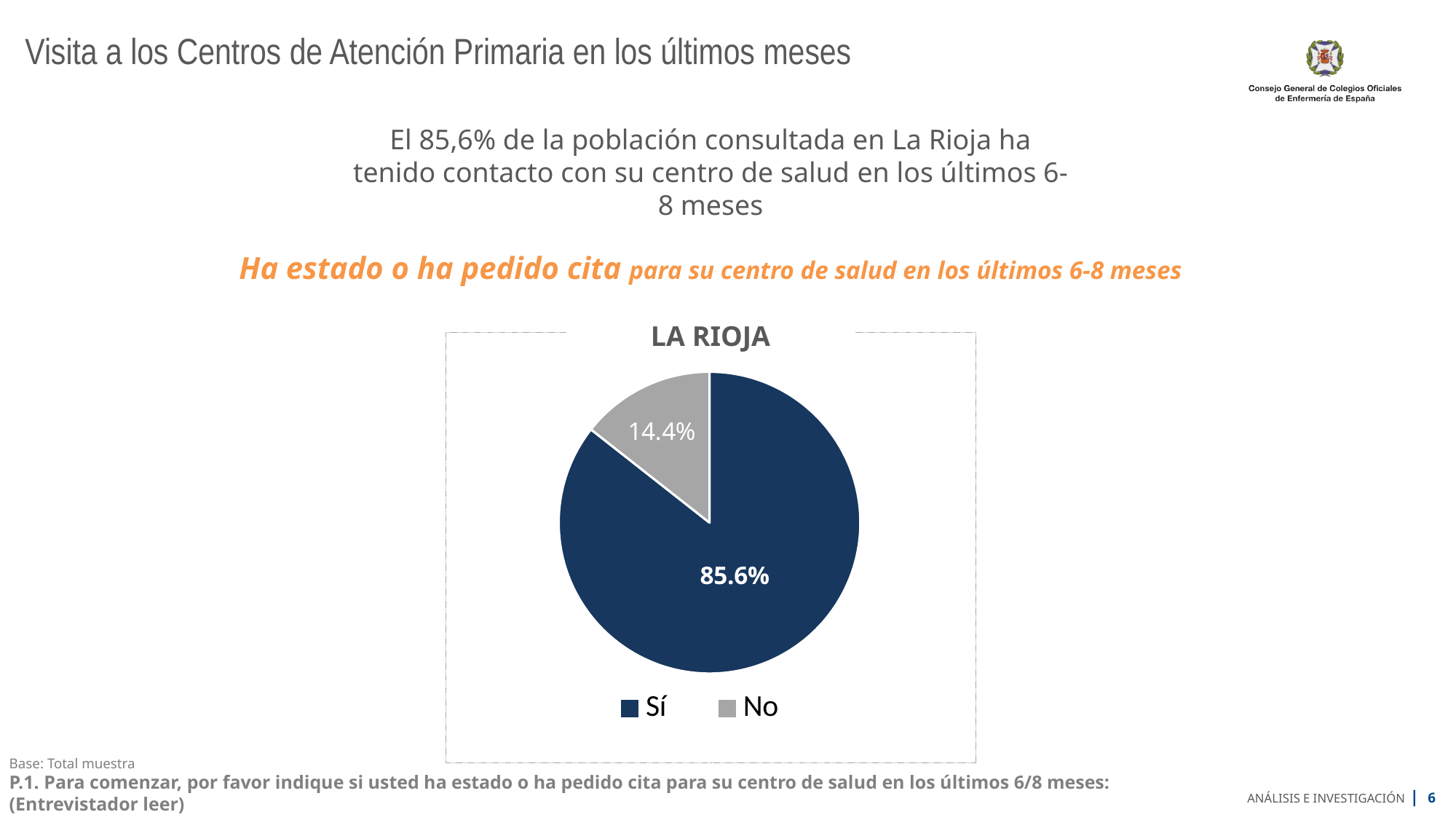
Which category has the largest slice in the LA RIOJA pie chart? Sí What percentage of respondents answered "Sí" in the LA RIOJA pie chart? 85.6% What is the difference in percentage points between the "Sí" and "No" slices in the LA RIOJA pie chart? 71.2% What share of the LA RIOJA pie does the "No" slice represent? 14.4% What kind of chart is shown on the slide? Pie chart Which category has the smallest slice in the LA RIOJA pie chart? No What is the title of the pie chart on the slide? LA RIOJA Which is larger in the LA RIOJA pie chart, the "Sí" slice or the "No" slice? Sí What percentage of respondents answered "No" in the LA RIOJA pie chart? 14.4% What colour is the "Sí" slice in the LA RIOJA pie chart? Dark blue How many entries does the legend of the LA RIOJA chart list? 2 How many slices does the LA RIOJA pie chart have? 2